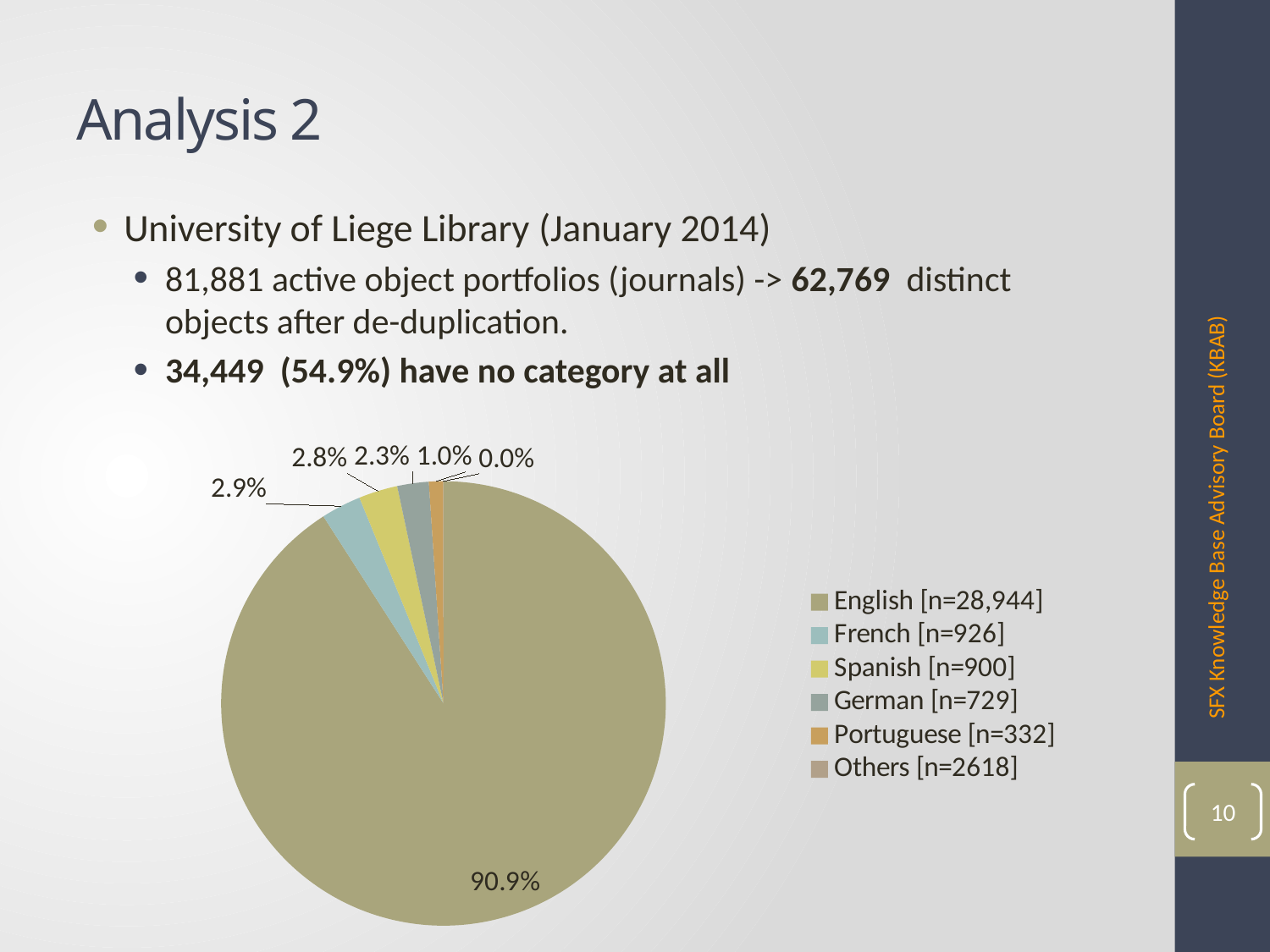
What share of the pie does Spanish have? 2.8% What share of the pie does German have? 2.3% Which category has the largest slice of the pie? English What share of the pie does English have? 90.9% What kind of chart is shown on the slide? pie chart What is the difference between the n values for French and Spanish in the legend? 26 Which has the larger share of the pie, French or German? French According to the legend, what is the n value for English? 28,944 How many categories does the pie chart's legend list? 6 According to the legend, what is the n value for Portuguese? 332